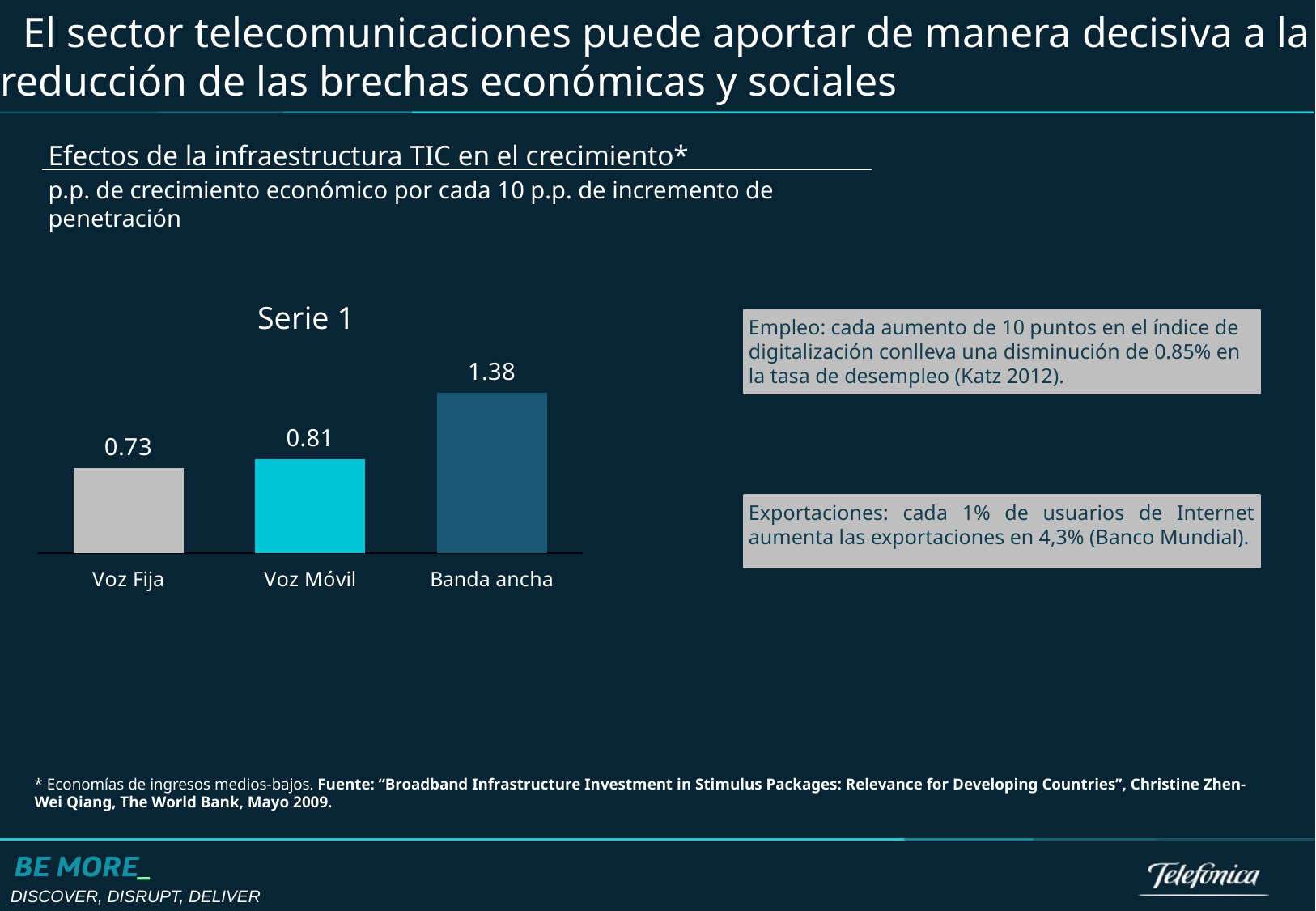
What is the difference between the values for Banda ancha and Voz Fija? 0.65 What is the value for Voz Móvil? 0.81 What is the title shown above the chart? Serie 1 Which category has the lowest value? Voz Fija Do the values rise or fall from Voz Fija to Banda ancha? Rise Which category has the highest value? Banda ancha What kind of chart is shown on the slide? Bar chart What is the value for Banda ancha? 1.38 What is the difference between the values for Voz Móvil and Voz Fija? 0.08 What is the value for Voz Fija? 0.73 Which is larger, the value for Banda ancha or the value for Voz Móvil? Banda ancha How many categories are shown in the chart? 3